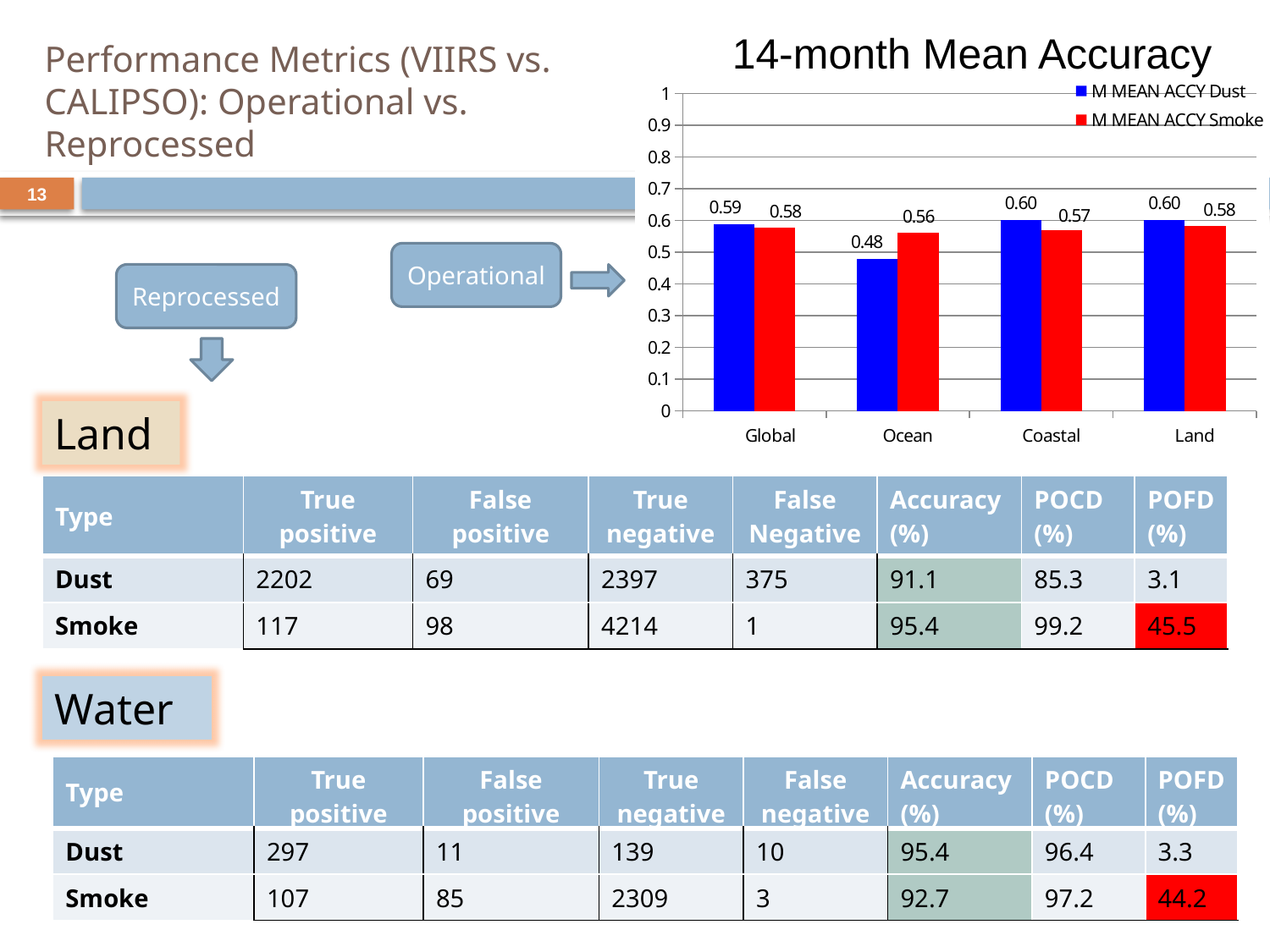
In the 14-month Mean Accuracy chart, what is the difference between the Smoke and Dust values for Ocean? 0.08 How many categories are shown on the x axis of the 14-month Mean Accuracy chart? 4 In the 14-month Mean Accuracy chart, which colour represents M MEAN ACCY Smoke? red In the 14-month Mean Accuracy chart, is the M MEAN ACCY Dust value for Ocean greater or less than 0.5? less What is the M MEAN ACCY Smoke value for Land in the 14-month Mean Accuracy chart? 0.58 What is the M MEAN ACCY Dust value for Global in the 14-month Mean Accuracy chart? 0.59 Which category has the lowest M MEAN ACCY Dust value in the 14-month Mean Accuracy chart? Ocean What is the M MEAN ACCY Smoke value for Coastal in the 14-month Mean Accuracy chart? 0.57 How many series does the legend of the 14-month Mean Accuracy chart list? 2 In the 14-month Mean Accuracy chart, which is larger for Ocean: the Dust value or the Smoke value? Smoke What is the M MEAN ACCY Dust value for Ocean in the 14-month Mean Accuracy chart? 0.48 What kind of chart is the 14-month Mean Accuracy chart? bar chart